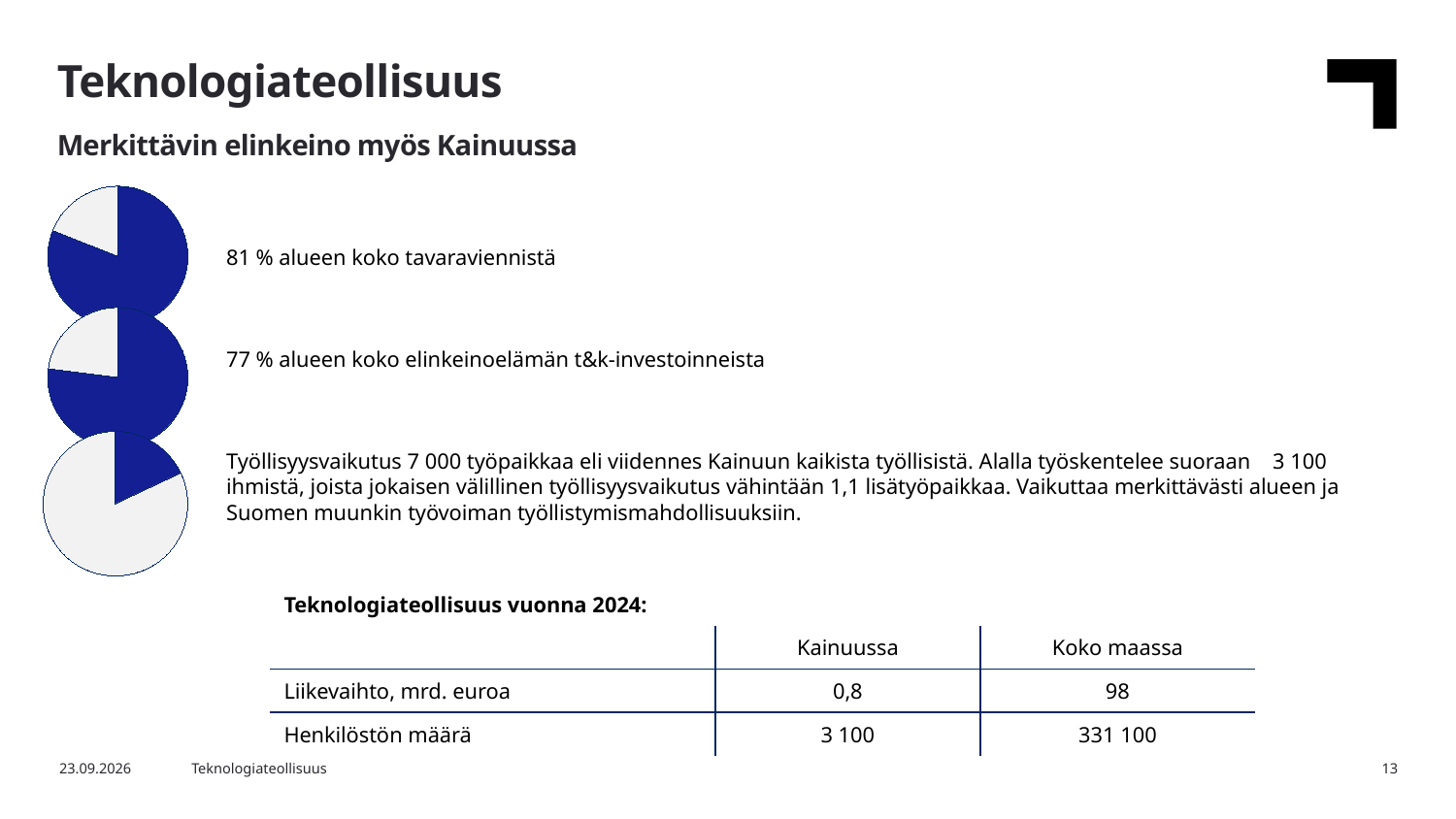
Which pie chart has the larger dark blue slice, the middle one (t&k-investoinnit) or the bottom one (työllisyysvaikutus)? The middle one (t&k-investoinnit) In the top pie chart, what share of the region's total goods exports (tavaravienti) does the dark blue slice represent? 81 % In the middle pie chart, what share of the region's business R&D investments (t&k-investoinnit) does the dark blue slice represent? 77 % How many slices does each pie chart on the slide have? 2 What is the difference in percentage points between the dark blue share in the top pie chart (81 %) and in the middle pie chart (77 %)? 4 percentage points Of the three pie charts, which one has the largest dark blue slice? The top one (tavaravienti) Which pie chart has the larger dark blue slice, the top one (tavaravienti) or the middle one (t&k-investoinnit)? The top one (tavaravienti) Of the three pie charts, which one has the smallest dark blue slice? The bottom one (työllisyysvaikutus) In the bottom pie chart, is the dark blue slice greater or less than half of the pie? Less What colour is the highlighted slice in each of the pie charts? Dark blue How many pie charts are shown on the slide? 3 What kind of chart is the top chart on the left of the slide? Pie chart